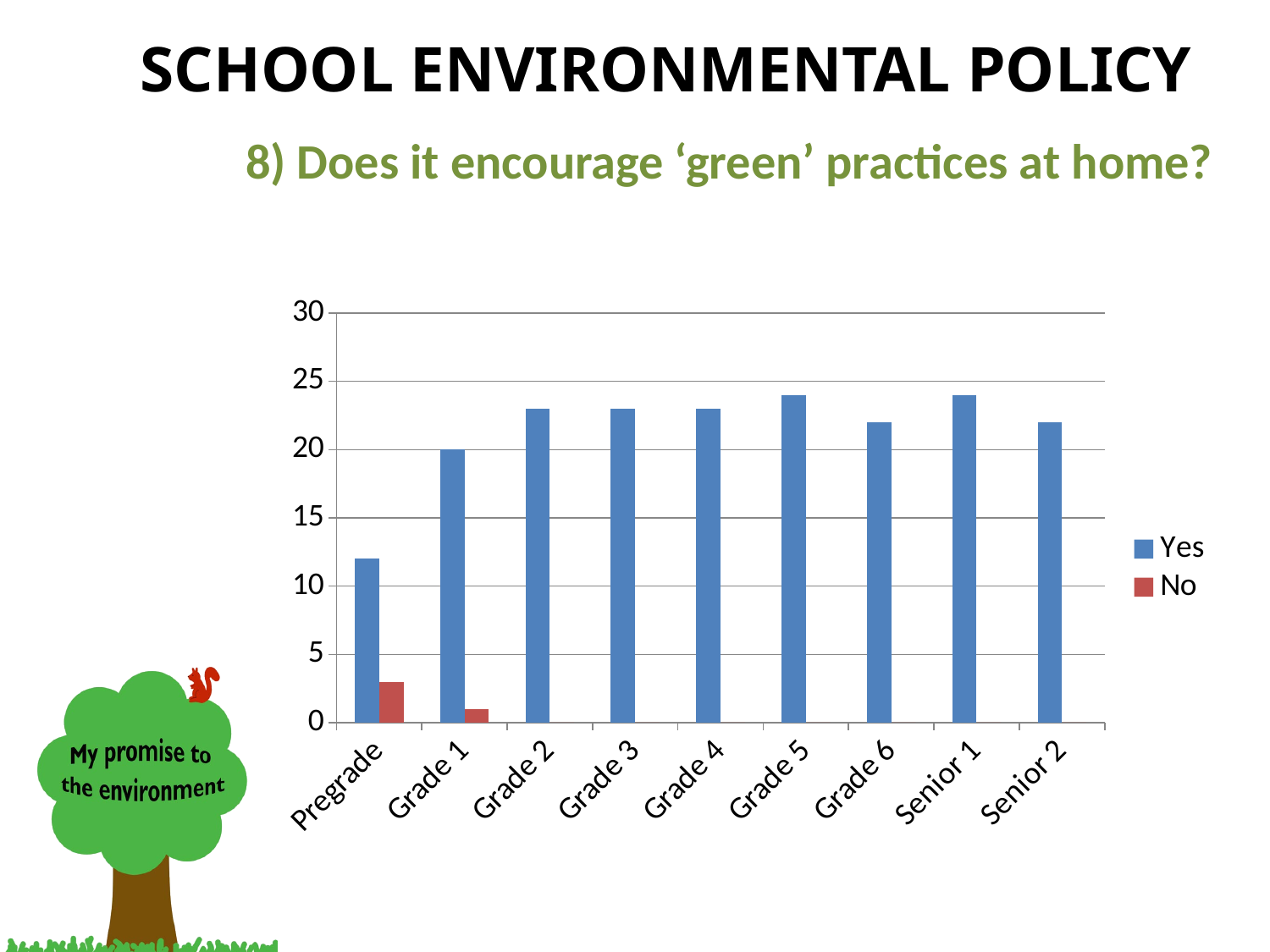
Is the Yes value for Grade 5 greater or less than 20? greater Do the Yes values rise or fall from Pregrade to Grade 2? rise What are the two series named in the legend? Yes and No How many series does the legend list? 2 How many grade categories are shown on the x axis? 9 Which is larger, the Yes value for Pregrade or the No value for Pregrade? Yes What kind of chart is shown on the slide? bar chart Is the No value for Pregrade greater or less than 5? less Is the Yes value for Pregrade greater or less than 15? less Which is larger, the Yes value for Pregrade or the Yes value for Grade 1? Grade 1 Which category has the lowest Yes value? Pregrade